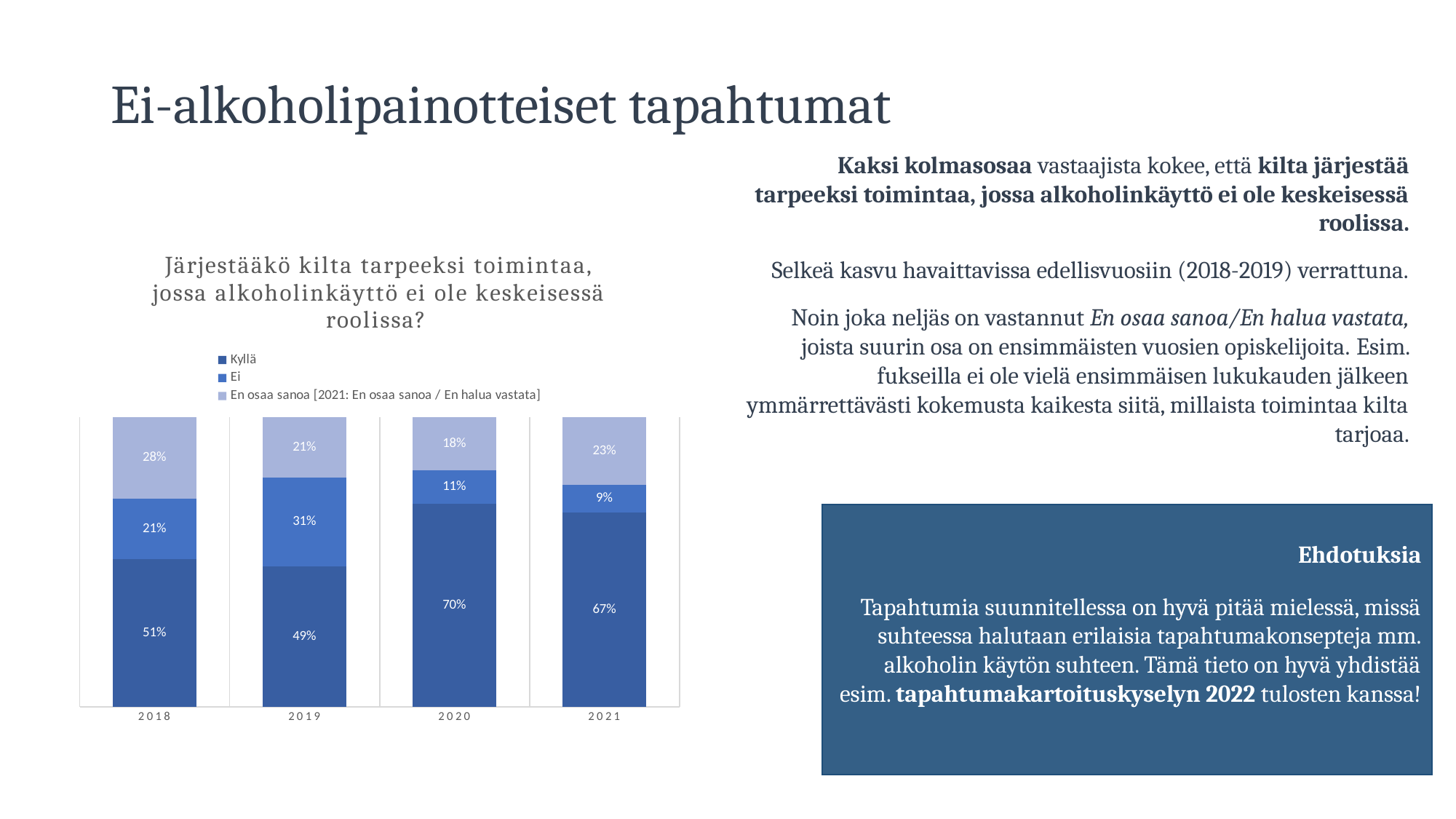
How many series does the legend list? 3 What kind of chart is shown on the slide? Stacked bar chart Which is larger, the En osaa sanoa value for 2019 or for 2021? 2021 How many years are shown on the x axis? 4 What is the value for Ei in 2019? 31% What is the title of the chart? Järjestääkö kilta tarpeeksi toimintaa, jossa alkoholinkäyttö ei ole keskeisessä roolissa? In which year is the Ei share lowest? 2021 What is the value for En osaa sanoa in 2018? 28% In which year is the Kyllä share highest? 2020 What is the value for Kyllä in 2020? 70% What is the value for Ei in 2021? 9% What is the difference between the Kyllä values for 2020 and 2018? 19%